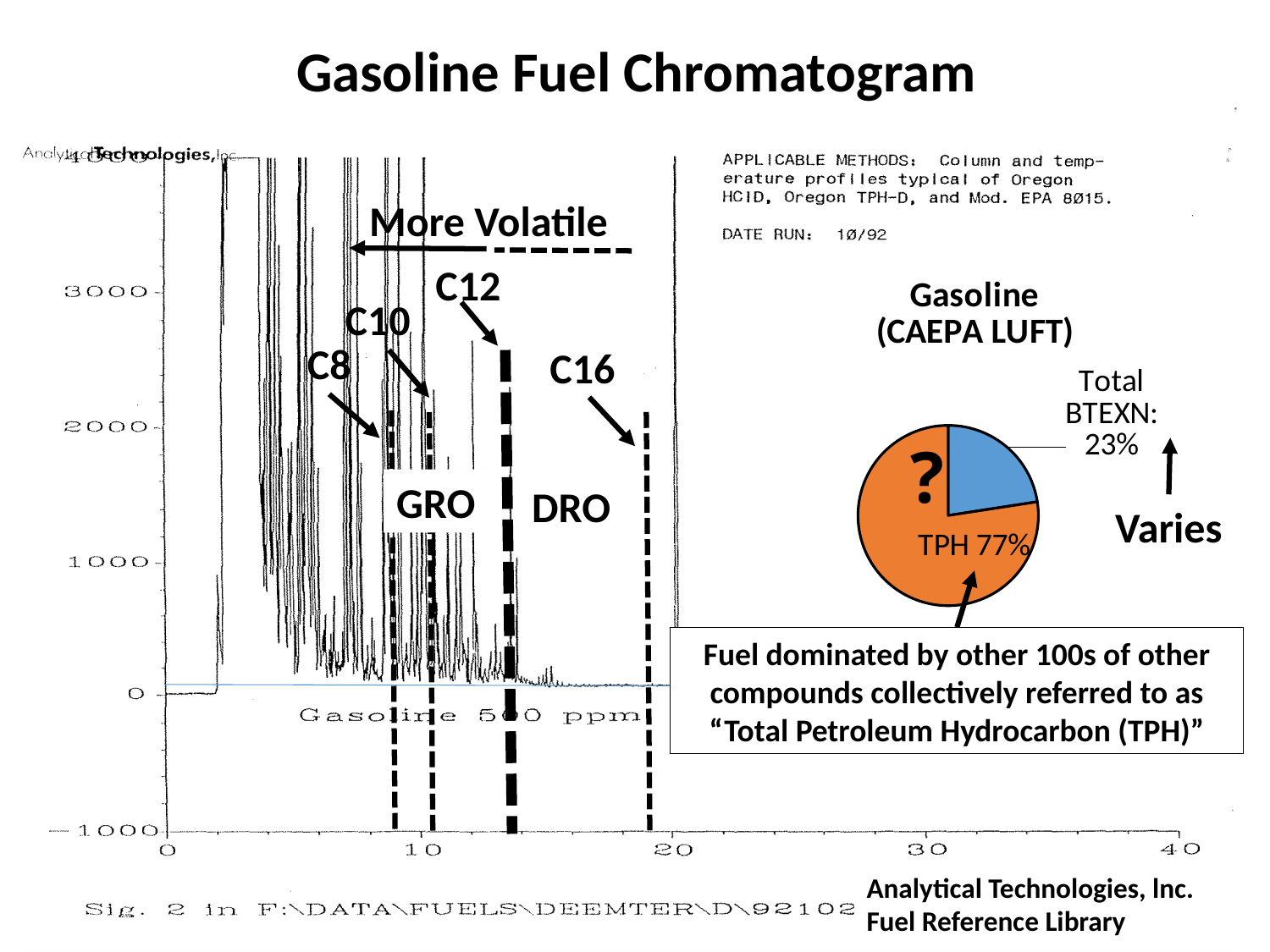
On the pie chart titled Gasoline (CAEPA LUFT), what share does Total BTEXN have? 23% What kind of chart is the large chromatogram on the left side of the slide? Line chart On the pie chart titled Gasoline (CAEPA LUFT), by how many percentage points does TPH exceed Total BTEXN? 54 percentage points On the pie chart titled Gasoline (CAEPA LUFT), is the share for TPH greater or less than 50%? greater What kind of chart is the one on the right side of the slide labelled Gasoline (CAEPA LUFT)? Pie chart On the pie chart titled Gasoline (CAEPA LUFT), what colour is the TPH slice? Orange On the chromatogram on the left side of the slide, what is the highest value shown on the x axis? 40 On the pie chart titled Gasoline (CAEPA LUFT), which slice is the largest? TPH On the pie chart titled Gasoline (CAEPA LUFT), how many slices are there? 2 On the pie chart titled Gasoline (CAEPA LUFT), which is larger, TPH or Total BTEXN? TPH On the pie chart titled Gasoline (CAEPA LUFT), what share does TPH have? 77% On the pie chart titled Gasoline (CAEPA LUFT), which slice is the smallest? Total BTEXN